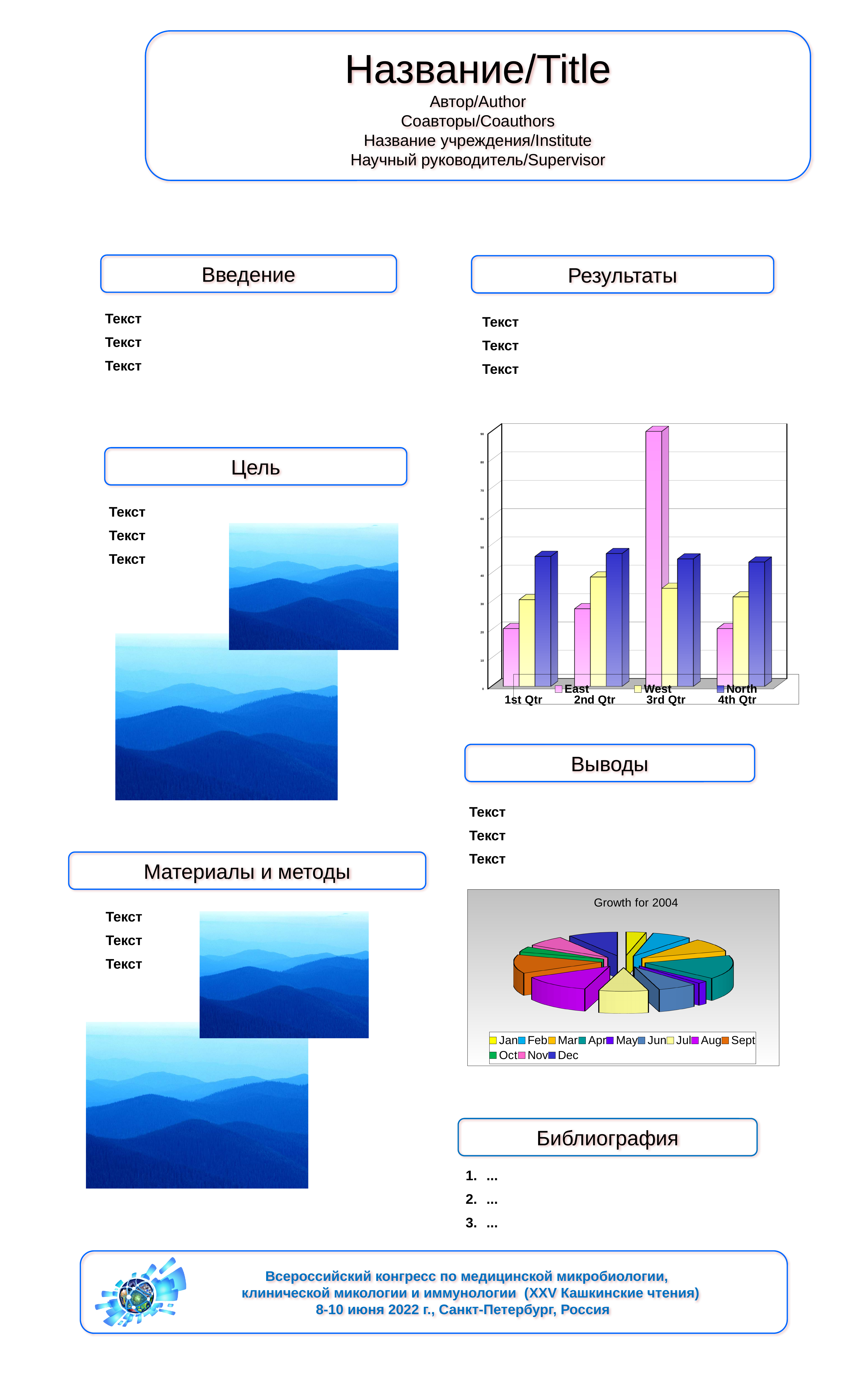
In the bar chart in the Результаты section, which is larger for 2nd Qtr: the East value or the West value? West In the bar chart in the Результаты section, which is larger for 1st Qtr: the East value or the North value? North In the bar chart in the Результаты section, how many series does the legend list? 3 What kind of chart is the chart titled 'Growth for 2004'? pie chart What is the title of the pie chart below the Выводы section? Growth for 2004 In the bar chart in the Результаты section, which quarter has the highest East value? 3rd Qtr In the bar chart in the Результаты section, how many quarter categories are shown on the x axis? 4 In the bar chart in the Результаты section, is the East value for 1st Qtr greater or less than 30? less In the bar chart in the Результаты section, is the East value for 3rd Qtr greater or less than 80? greater How many slices does the pie chart titled 'Growth for 2004' have? 12 In the bar chart in the Результаты section, is the North value for 2nd Qtr greater or less than 40? greater What kind of chart is shown in the Результаты section? bar chart